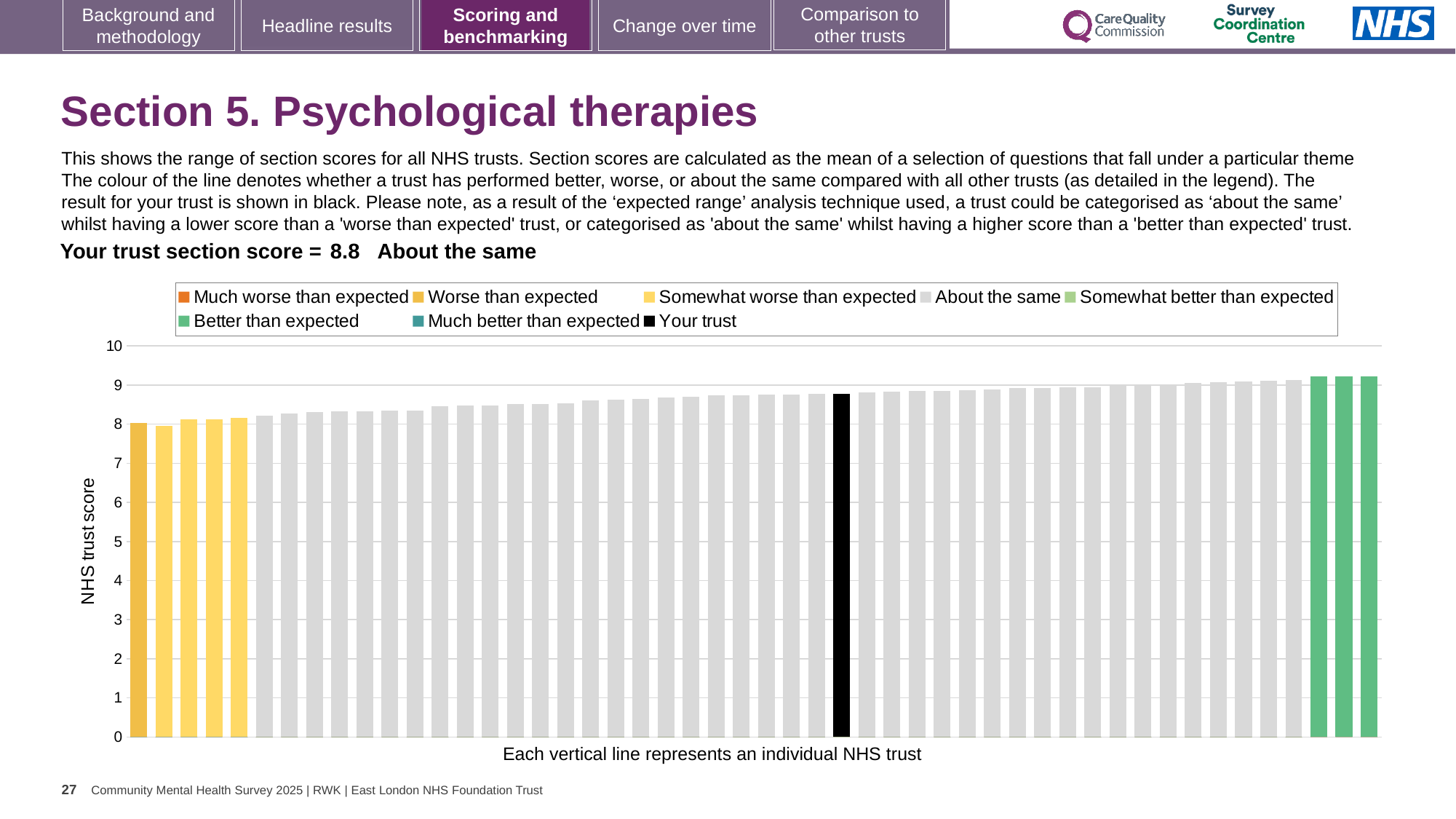
What is the section score for your trust shown on the slide? 8.8 How many bars are coloured as 'Better than expected'? 3 What is the label on the vertical axis of the chart? NHS trust score Is the value for your trust (the black bar) greater or less than 8? greater What kind of chart is shown on the slide? bar chart How many entries does the chart legend list? 8 Is the value for your trust (the black bar) greater or less than 9? less Are the green 'Better than expected' bars on the right greater or less than 9? greater Do the bar values rise or fall from left to right across the chart? rise Which category is your trust's section score placed in? About the same Which is larger: the value for your trust (black bar) or the leftmost bar? your trust